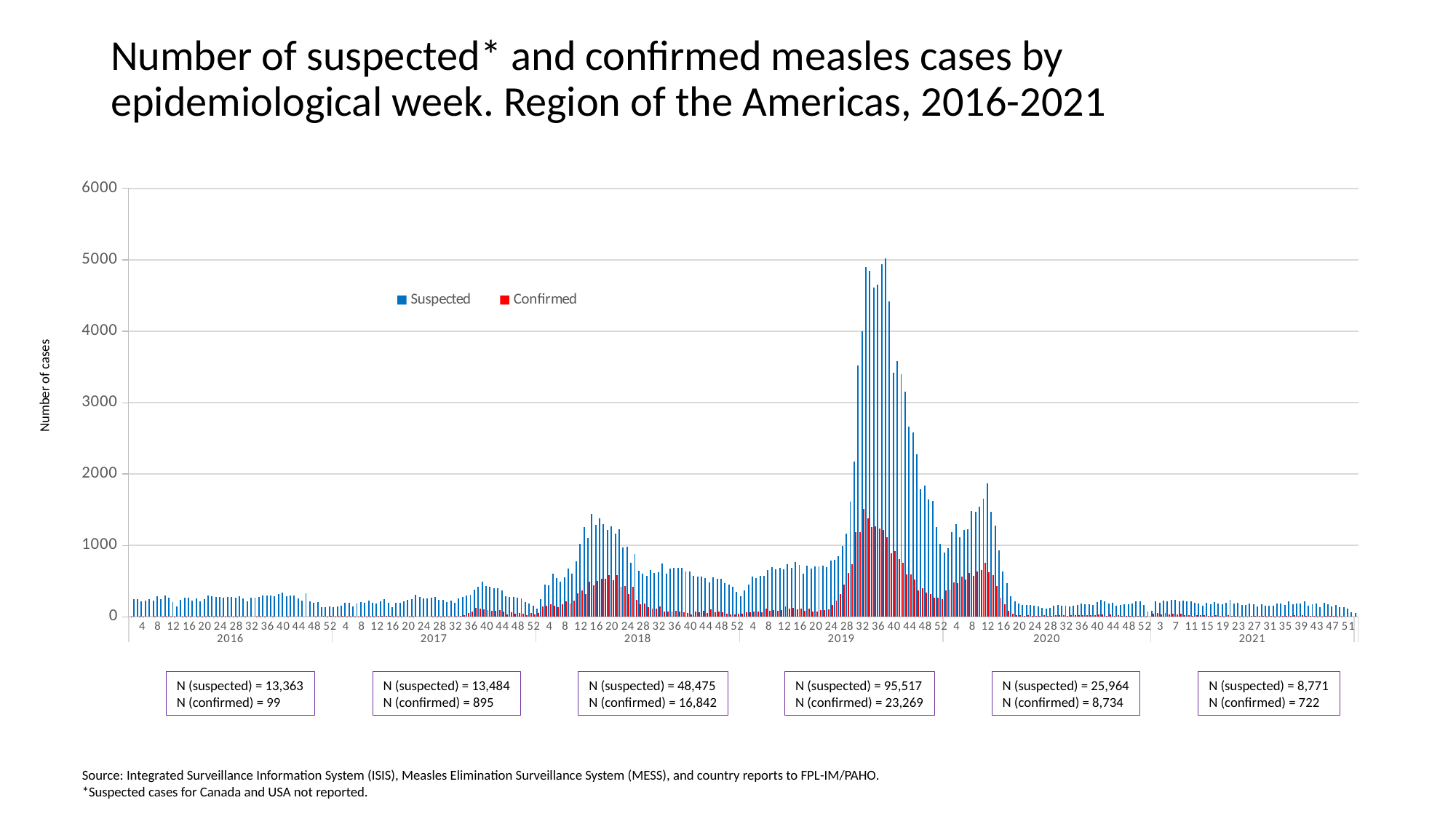
Which year has the highest annual number of suspected cases? 2019 What is the number of suspected cases (N suspected) for 2019? 95,517 What is the number of confirmed cases (N confirmed) for 2018? 16,842 How many years are shown along the x axis? 6 Which year has more confirmed cases, 2017 or 2020? 2020 What kind of chart is shown on the slide? bar chart How many series does the legend list? 2 Which year has the lowest annual number of confirmed cases? 2016 What is the difference between the annual suspected cases in 2019 and 2018? 47,042 What is the label on the vertical axis? Number of cases Is the peak weekly value of suspected cases in 2019 greater or less than 4000? greater What are the two series named in the legend? Suspected and Confirmed